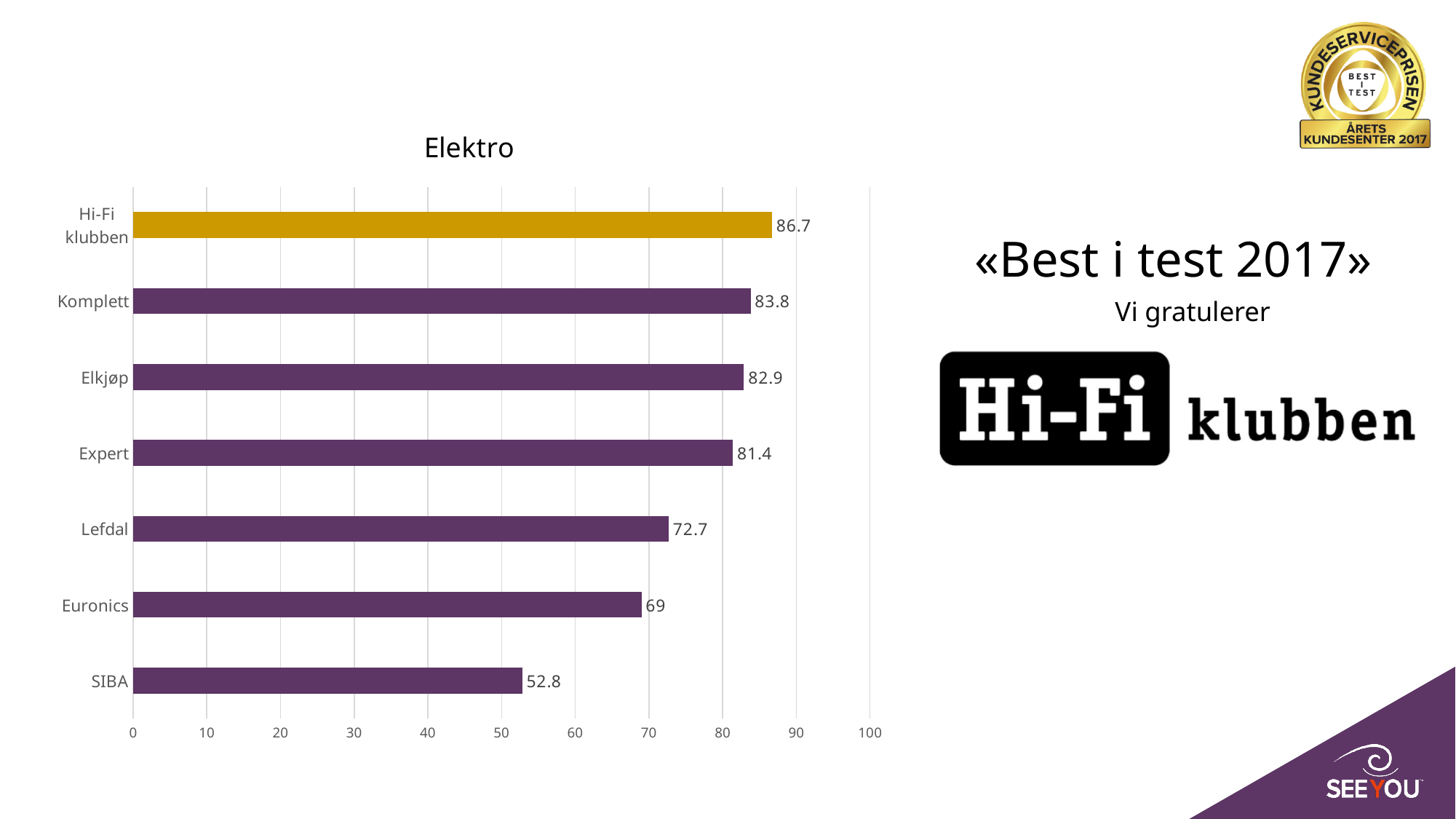
What is the title of the chart? Elektro Which category has the highest value? Hi-Fi klubben What is the value for Lefdal? 72.7 What is the value for Hi-Fi klubben? 86.7 What kind of chart is shown on the slide? bar chart Which is larger, the value for Expert or the value for Lefdal? Expert How many categories are shown in the chart? 7 What is the value for Euronics? 69 What is the difference between the values for Hi-Fi klubben and Komplett? 2.9 What is the difference between the values for Euronics and SIBA? 16.2 Is the value for SIBA greater or less than 60? less Which category has the lowest value? SIBA